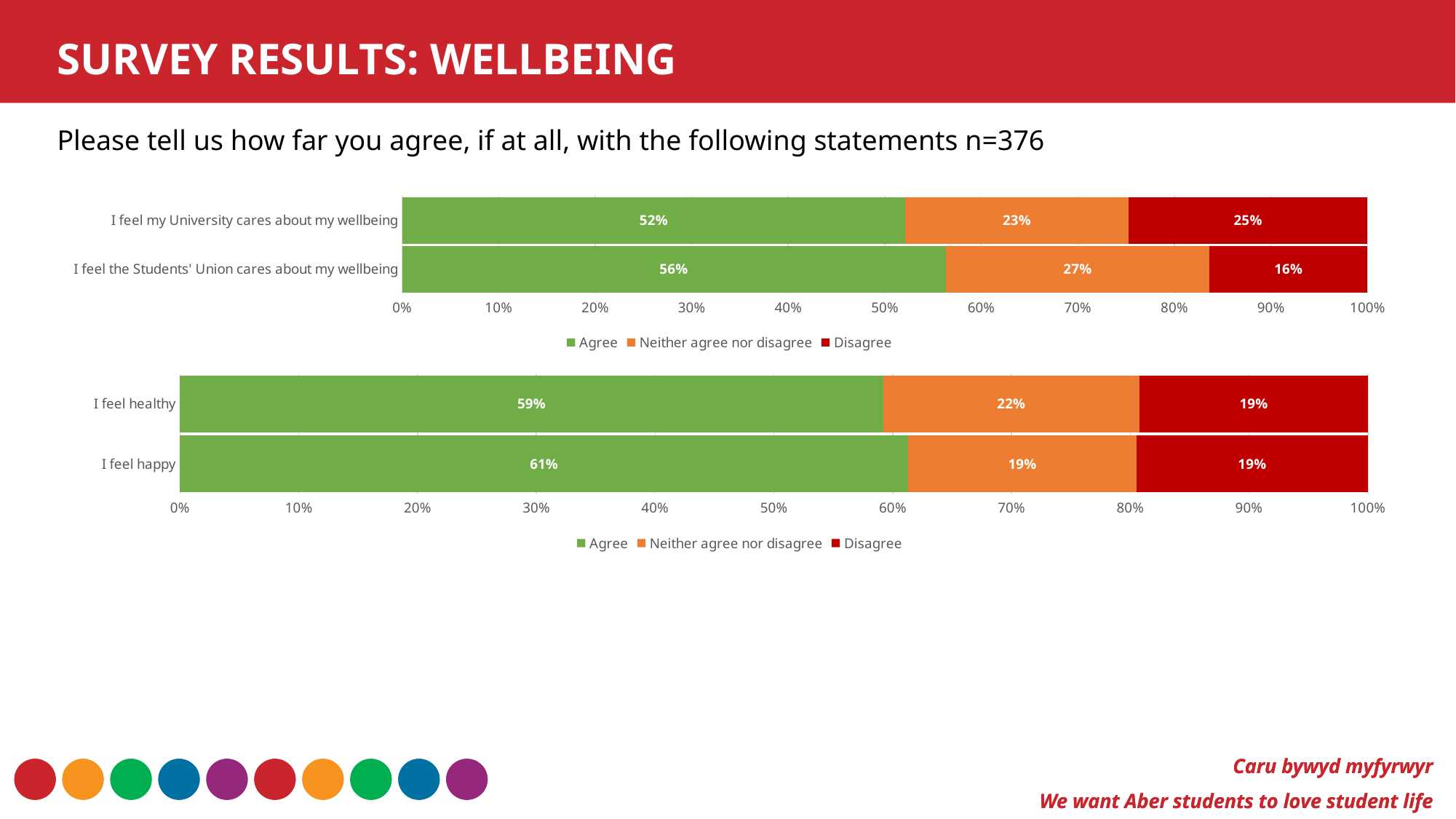
What type of chart is the bottom chart? Stacked bar chart In the top chart, what is the difference between the Agree percentages for the Students' Union statement and the University statement? 4% In the top chart, what percentage disagree with 'I feel the Students' Union cares about my wellbeing'? 16% In the top chart, which statement has the higher Disagree percentage? I feel my University cares about my wellbeing In the bottom chart, what percentage agree with 'I feel happy'? 61% How many series does the legend of the top chart list? 3 In the bottom chart, which statement has the lower Agree percentage? I feel healthy In the top chart, what percentage agree with 'I feel my University cares about my wellbeing'? 52% In the top chart, is the Neither agree nor disagree percentage larger for the University statement or the Students' Union statement? Students' Union statement How many statements are shown in the bottom chart? 2 In the bottom chart, what is the difference between the Neither agree nor disagree percentages for 'I feel healthy' and 'I feel happy'? 3% In the bottom chart, what percentage neither agree nor disagree with 'I feel healthy'? 22%